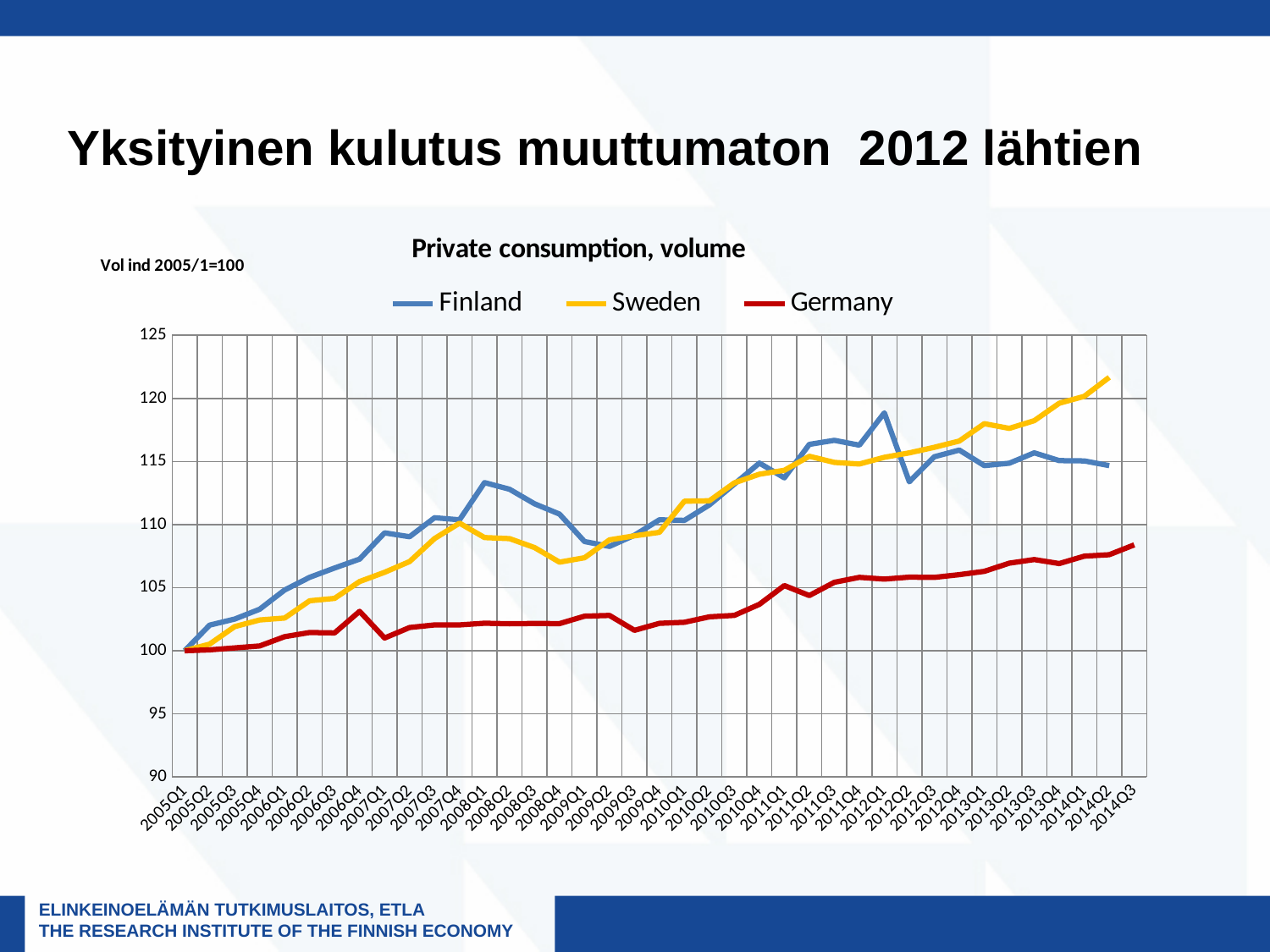
In 2008Q1, which is higher, Finland or Sweden? Finland Which colour is used for the Germany line? red What is the value for Finland in 2005Q1? 100 What is the title of the chart? Private consumption, volume What kind of chart is shown on the slide? line chart How many series does the legend list? 3 Is the value for Germany in 2014Q3 greater or less than 110? less Is the value for Finland in 2012Q1 greater or less than 115? greater How many quarters are labelled on the x axis, from 2005Q1 to 2014Q3? 39